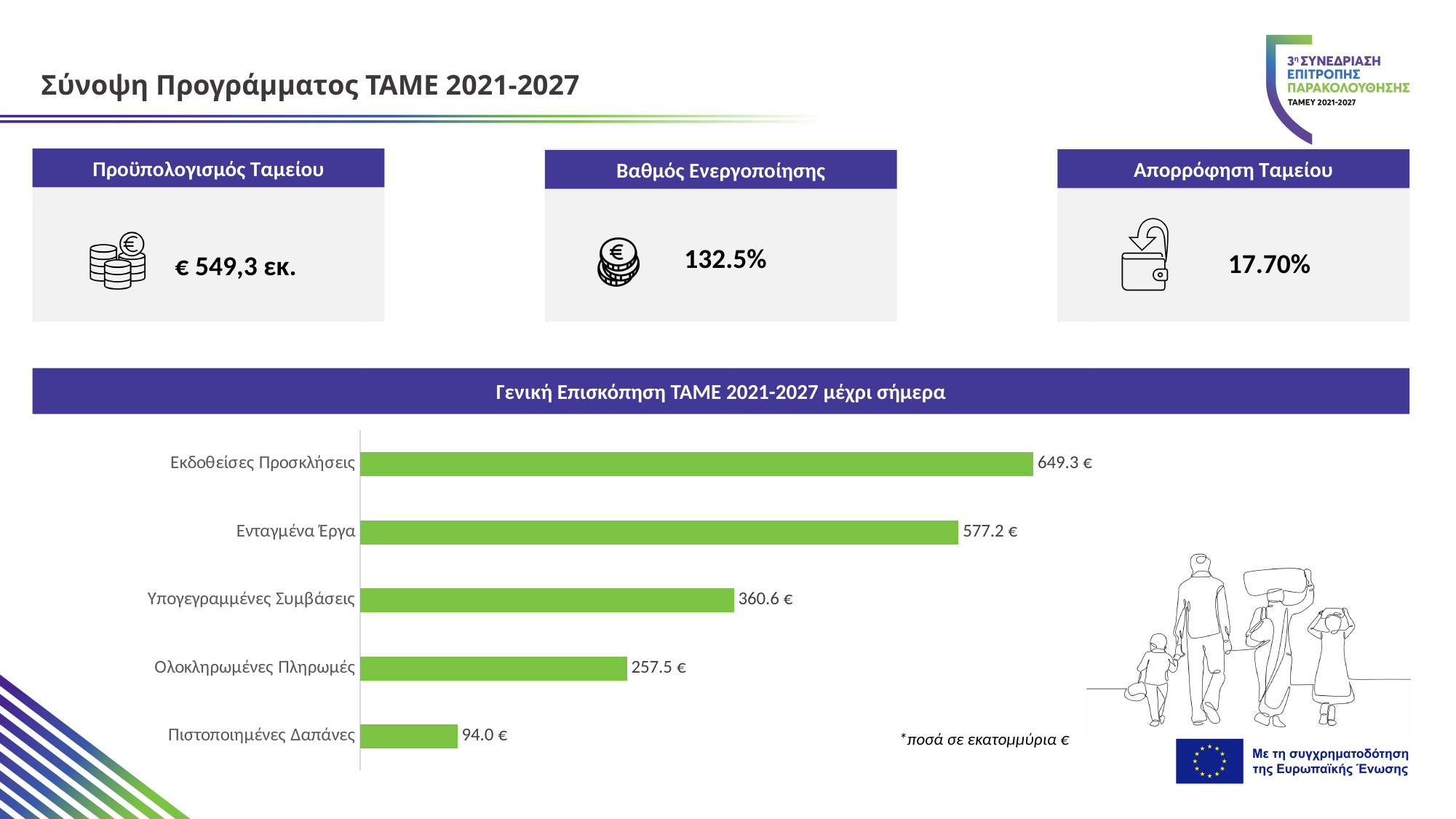
How many categories are shown in the chart? 5 Which is larger, Υπογεγραμμένες Συμβάσεις or Ολοκληρωμένες Πληρωμές? Υπογεγραμμένες Συμβάσεις What is the value for Πιστοποιημένες Δαπάνες? 94.0 € Which category has the lowest value? Πιστοποιημένες Δαπάνες What is the title of the chart? Γενική Επισκόπηση ΤΑΜΕ 2021-2027 μέχρι σήμερα Which category has the highest value? Εκδοθείσες Προσκλήσεις What kind of chart is shown on the slide? Bar chart What is the value for Εκδοθείσες Προσκλήσεις? 649.3 € What is the value for Υπογεγραμμένες Συμβάσεις? 360.6 € What is the value for Ενταγμένα Έργα? 577.2 € What is the difference between Ολοκληρωμένες Πληρωμές and Πιστοποιημένες Δαπάνες? 163.5 € What is the difference between Εκδοθείσες Προσκλήσεις and Ενταγμένα Έργα? 72.1 €